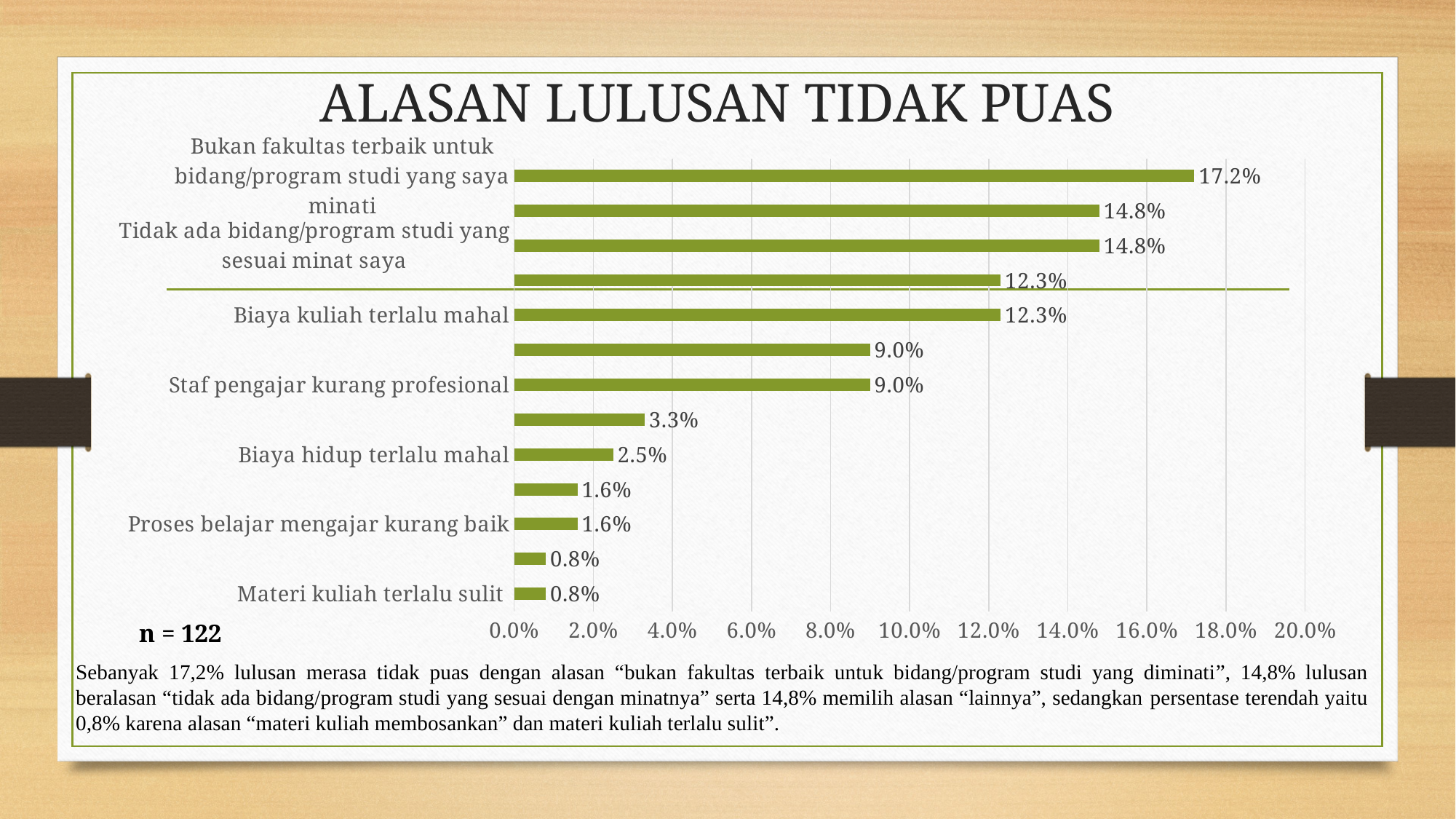
How many bars are plotted in the chart? 13 What is the value for "Staf pengajar kurang profesional"? 9.0% What is the value for "Biaya kuliah terlalu mahal"? 12.3% What is the difference between the value for "Bukan fakultas terbaik untuk bidang/program studi yang saya minati" and the value for "Biaya kuliah terlalu mahal"? 4.9% What type of chart is shown on the slide? Bar chart What is the value for "Materi kuliah terlalu sulit"? 0.8% Which category has the highest value in the chart? Bukan fakultas terbaik untuk bidang/program studi yang saya minati What is the value for "Tidak ada bidang/program studi yang sesuai minat saya"? 14.8% What is the value for "Bukan fakultas terbaik untuk bidang/program studi yang saya minati"? 17.2% Which is larger: the value for "Biaya kuliah terlalu mahal" or the value for "Staf pengajar kurang profesional"? Biaya kuliah terlalu mahal What is the title of the chart? ALASAN LULUSAN TIDAK PUAS What is the lowest value shown in the chart? 0.8%